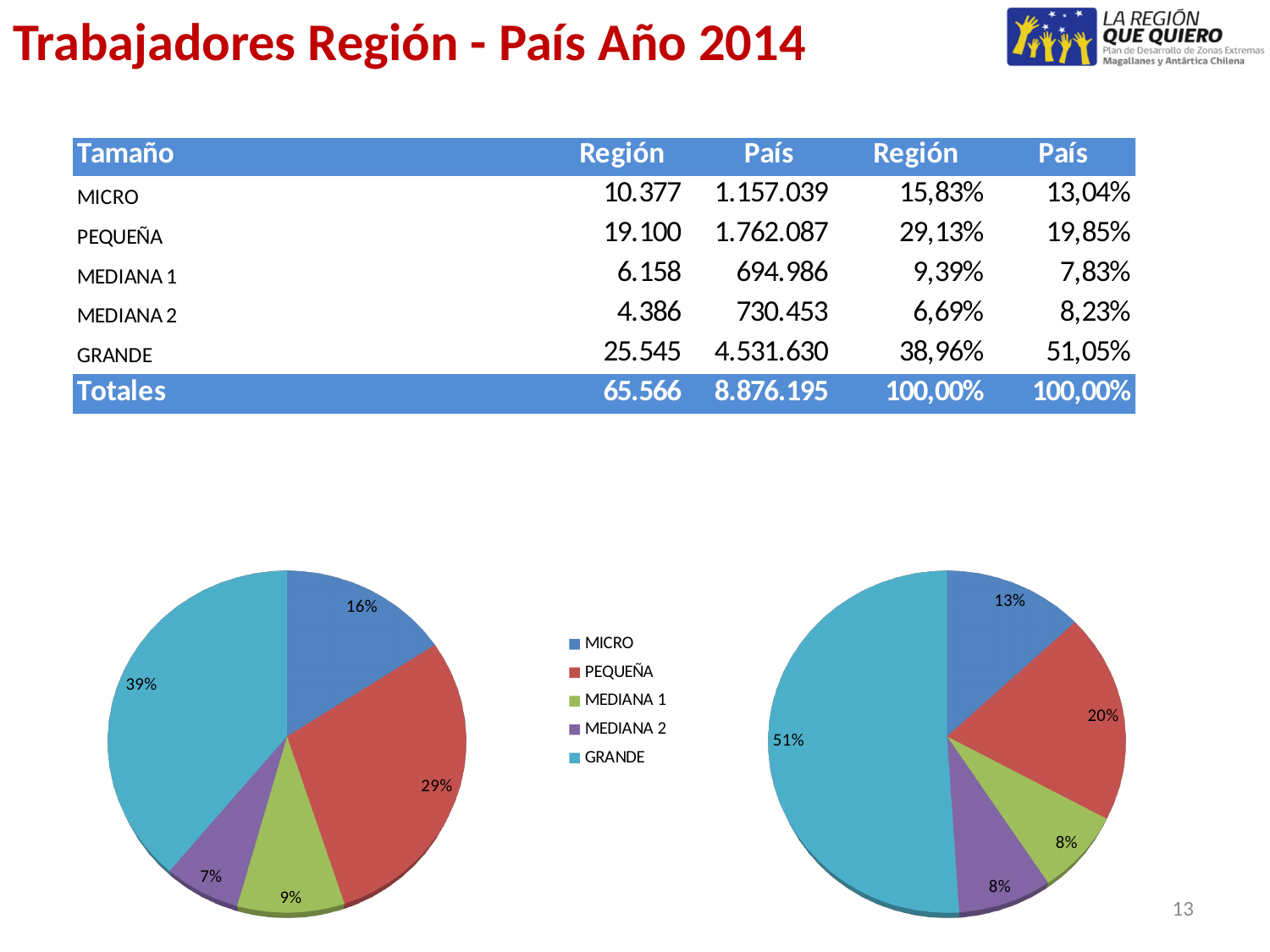
In the right pie chart, what share does the MICRO slice have? 13% How many slices does each pie chart have? 5 In the left pie chart, which category has the largest slice? GRANDE In the left pie chart, which category has the smallest slice? MEDIANA 2 In the right pie chart, which category has the largest slice? GRANDE In the right pie chart, what is the difference between the GRANDE and PEQUEÑA shares? 31% In the left pie chart, what share does the GRANDE slice have? 39% In the right pie chart, what share does the GRANDE slice have? 51% How many series does the legend list? 5 What kind of charts are shown on the slide? Pie charts In the left pie chart, which is larger, the MICRO slice or the MEDIANA 1 slice? MICRO